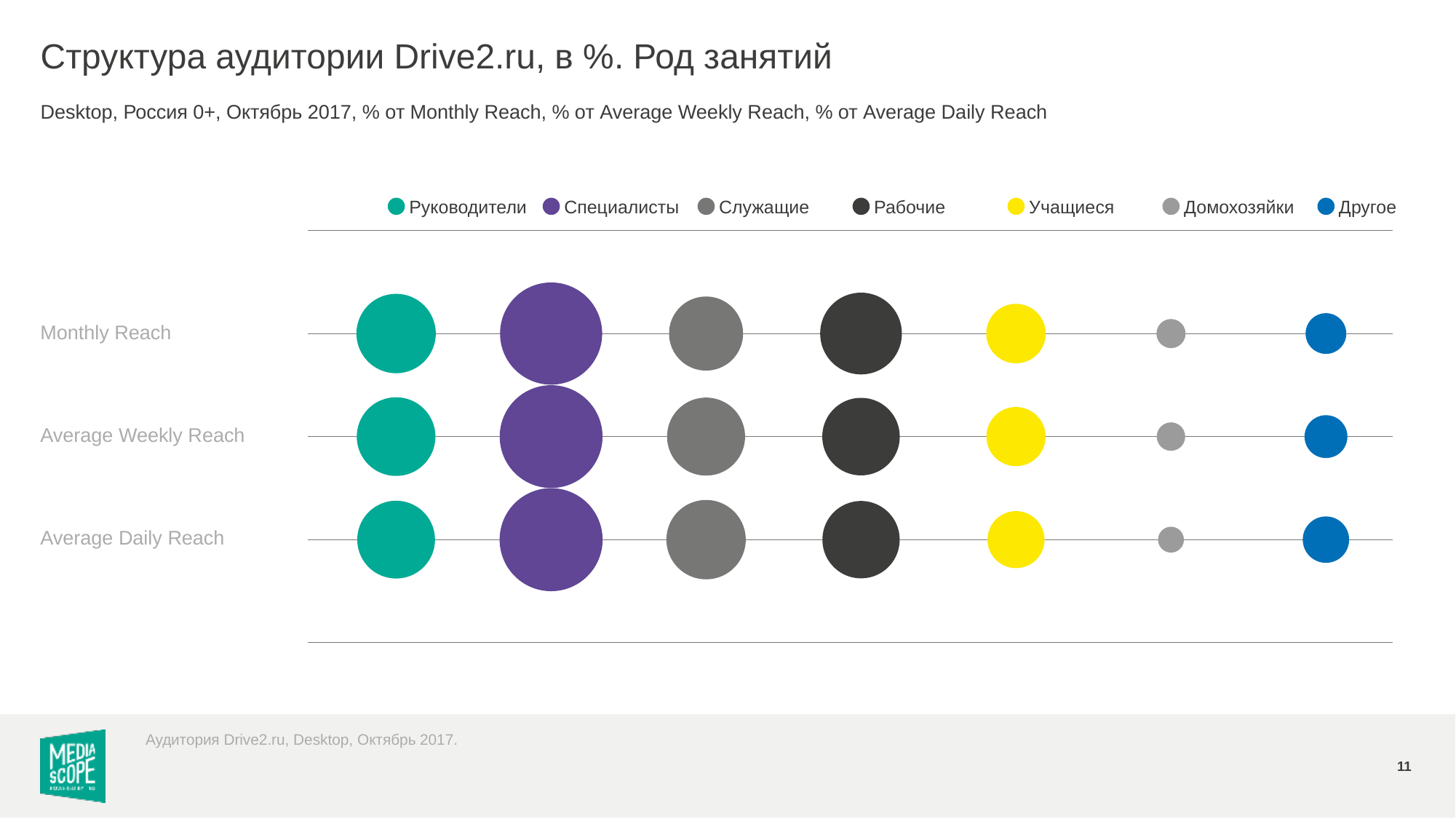
What kind of chart is shown on the slide? bubble chart Which occupation group has the largest bubble in the Average Daily Reach row? Специалисты What is the title of the chart on the slide? Структура аудитории Drive2.ru, в %. Род занятий In the Monthly Reach row, which bubble is larger: Учащиеся or Домохозяйки? Учащиеся In the Average Daily Reach row, which bubble is larger: Другое or Домохозяйки? Другое What colour represents Учащиеся in the legend? yellow Which occupation group has the smallest bubble in the Monthly Reach row? Домохозяйки In the Average Weekly Reach row, which bubble is larger: Специалисты or Учащиеся? Специалисты Which occupation group has the smallest bubble in the Average Weekly Reach row? Домохозяйки Which occupation group has the largest bubble in the Monthly Reach row? Специалисты How many rows (reach categories) are plotted on the chart? 3 How many series does the legend list? 7